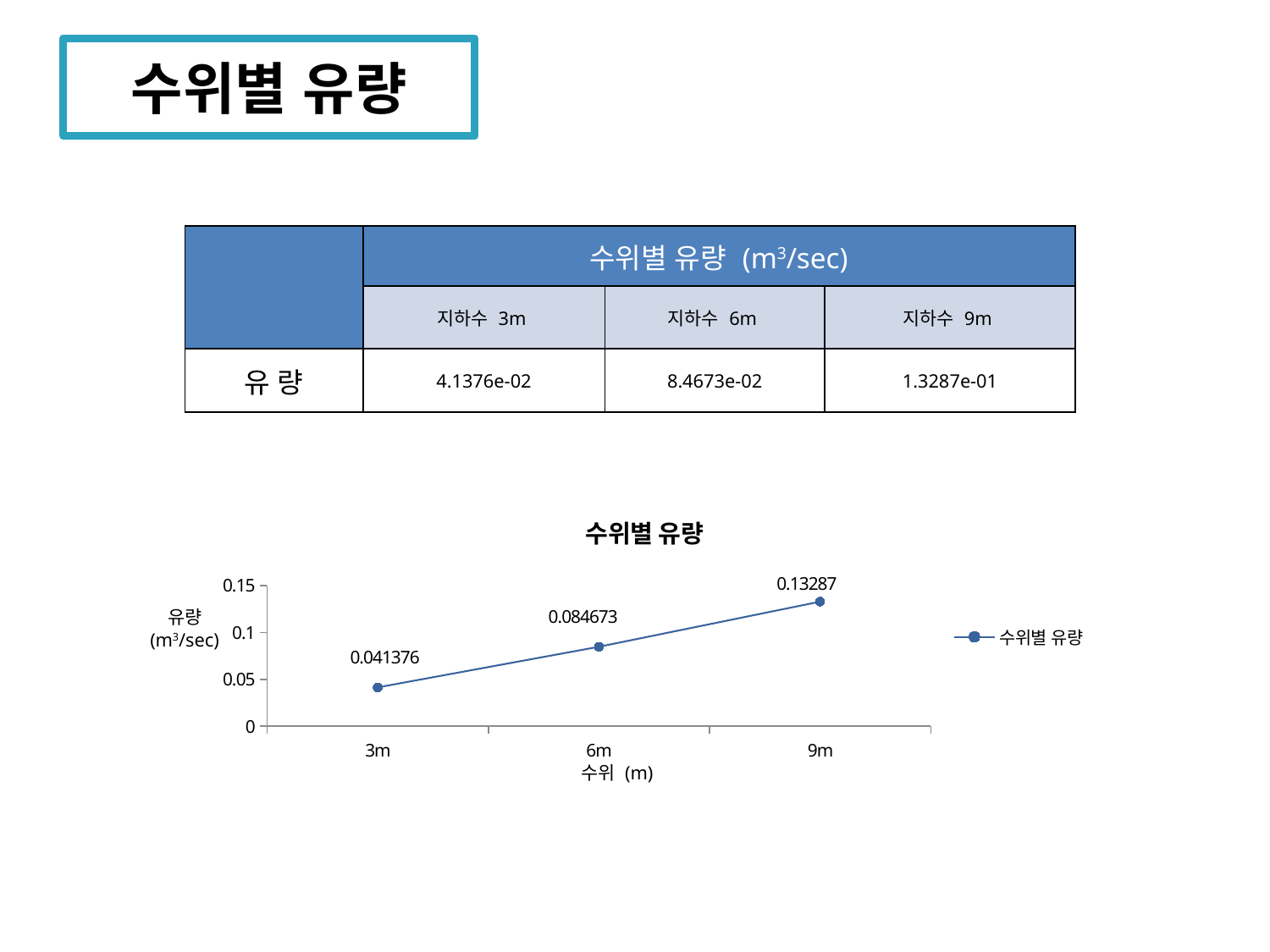
Which water level (수위) has the lowest 유량 value in the chart? 3m What is the value plotted for 9m in the chart? 0.13287 Do the values rise or fall as the water level increases from 3m to 9m? rise Which is larger, the value for 6m or the value for 9m? 9m What is the value plotted for 3m in the chart? 0.041376 What kind of chart is shown on the slide? line chart What is the difference between the values for 9m and 3m? 0.091494 Is the value for 9m greater or less than 0.1? greater What is the difference between the values for 6m and 3m? 0.043297 Which water level (수위) has the highest 유량 value in the chart? 9m What is the value plotted for 6m in the chart? 0.084673 How many data points are plotted in the chart? 3